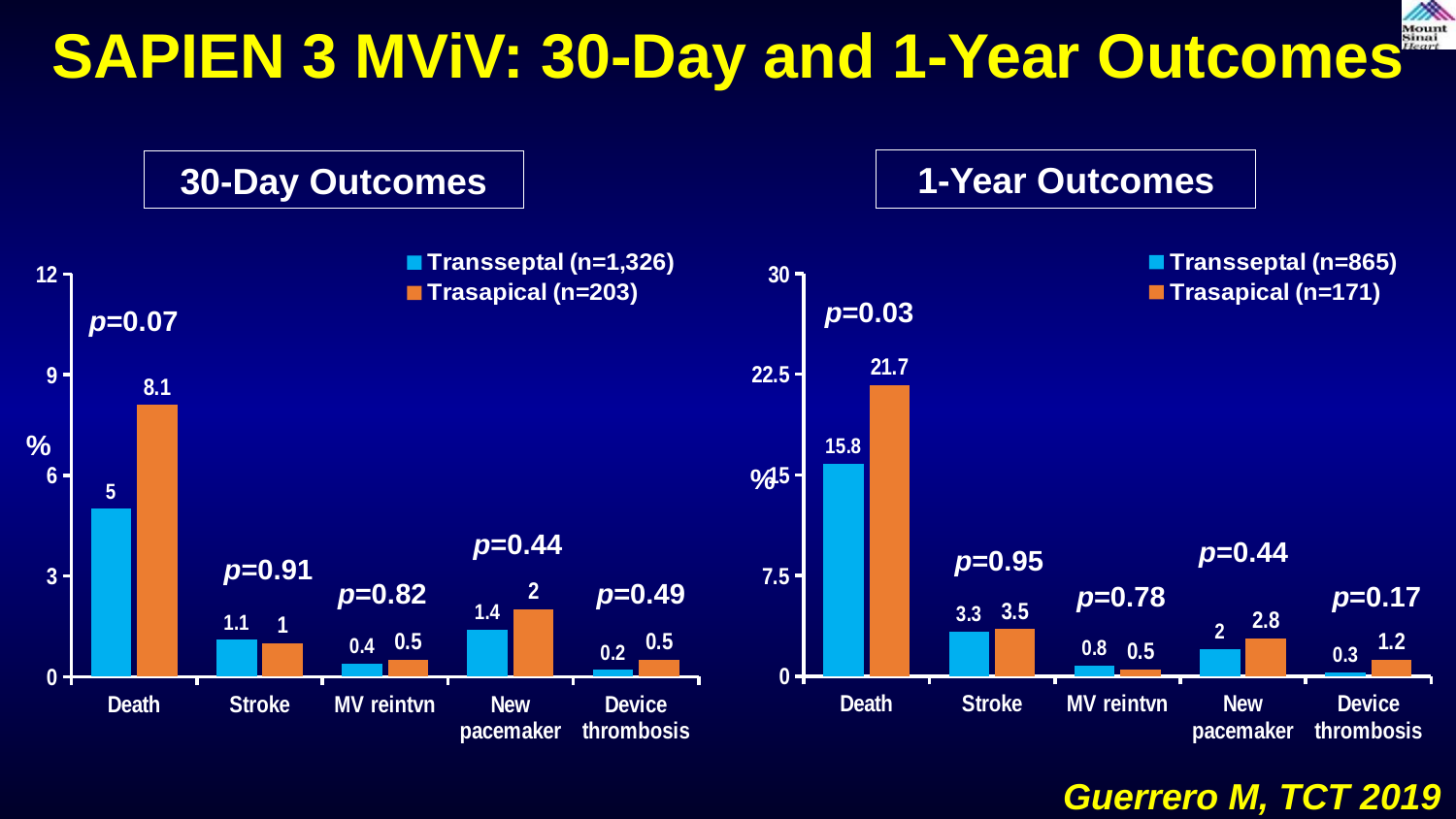
In the 30-Day Outcomes chart, what is the difference between the Trasapical and Transseptal Death values? 3.1 What kind of chart is the 30-Day Outcomes chart? Bar chart In the 30-Day Outcomes chart, which category has the lowest Transseptal value? Device thrombosis In the 1-Year Outcomes chart, which is larger for New pacemaker: Transseptal or Trasapical? Trasapical How many series does the legend of the 1-Year Outcomes chart list? 2 In the 30-Day Outcomes chart, what is the Death value for the Transseptal series? 5 In the 30-Day Outcomes chart, what is the Death value for the Trasapical series? 8.1 How many categories are shown on the x axis of the 30-Day Outcomes chart? 5 In the 1-Year Outcomes chart, what is the difference between the Trasapical and Transseptal Death values? 5.9 In the 1-Year Outcomes chart, what is the Death value for the Trasapical series? 21.7 In the 1-Year Outcomes chart, what is the Stroke value for the Transseptal series? 3.3 In the 1-Year Outcomes chart, which category has the highest Transseptal value? Death